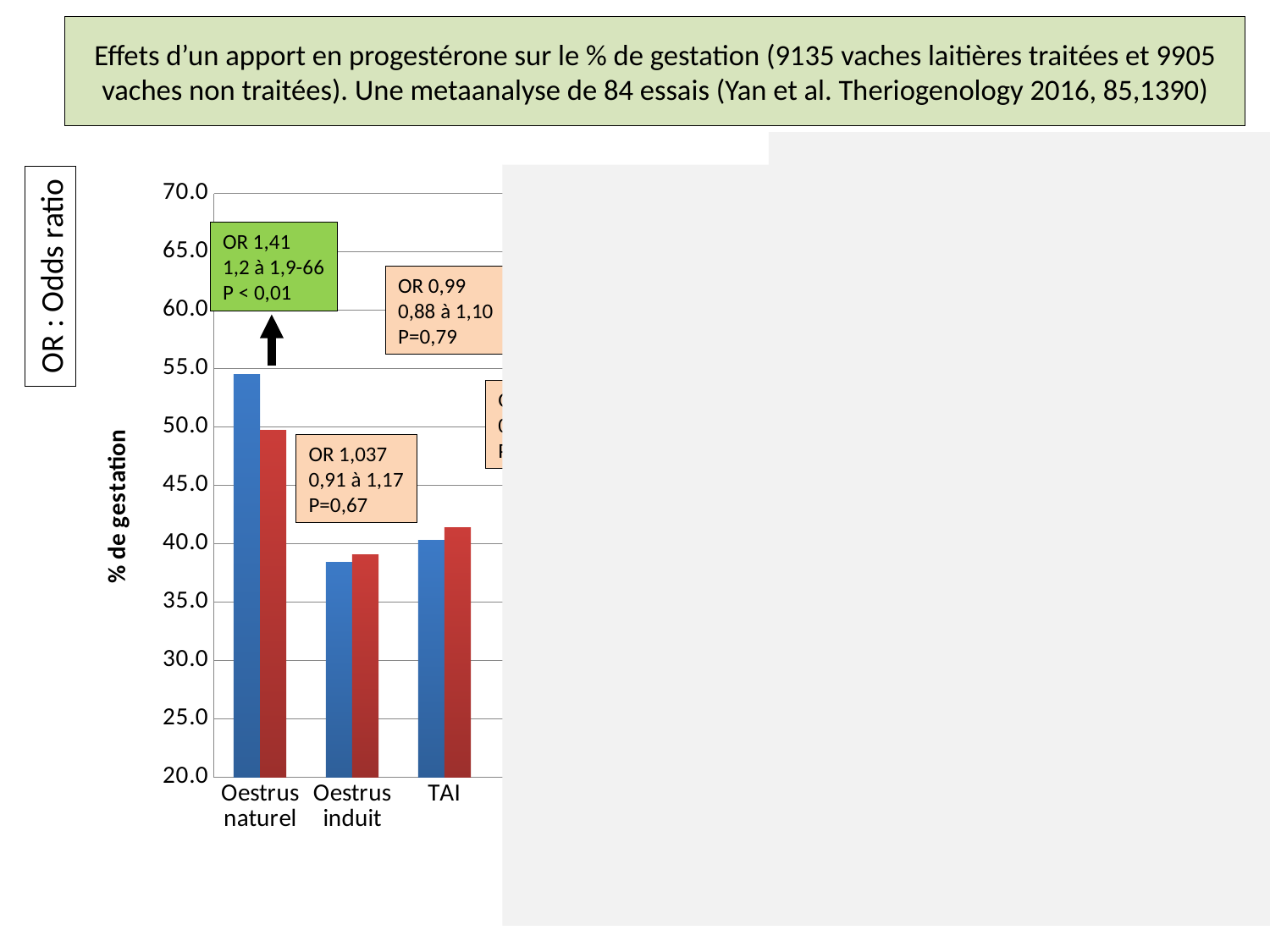
What kind of chart is shown on the slide? bar chart What is the title of the vertical axis of the chart? % de gestation Among the visible categories, which one has the shortest blue bar? Oestrus induit Is the value of the blue bar for Oestrus induit greater or less than 40? less Is the value of the blue bar for Oestrus naturel greater or less than 50? greater For Oestrus naturel, which bar is taller, the blue one or the red one? the blue one How many categories are visible on the x axis of the chart? 3 Among the visible categories, which one has the tallest blue bar? Oestrus naturel Is the value of the red bar for TAI greater or less than 40? greater What odds ratio is shown in the green box above the Oestrus naturel bars? OR 1,41